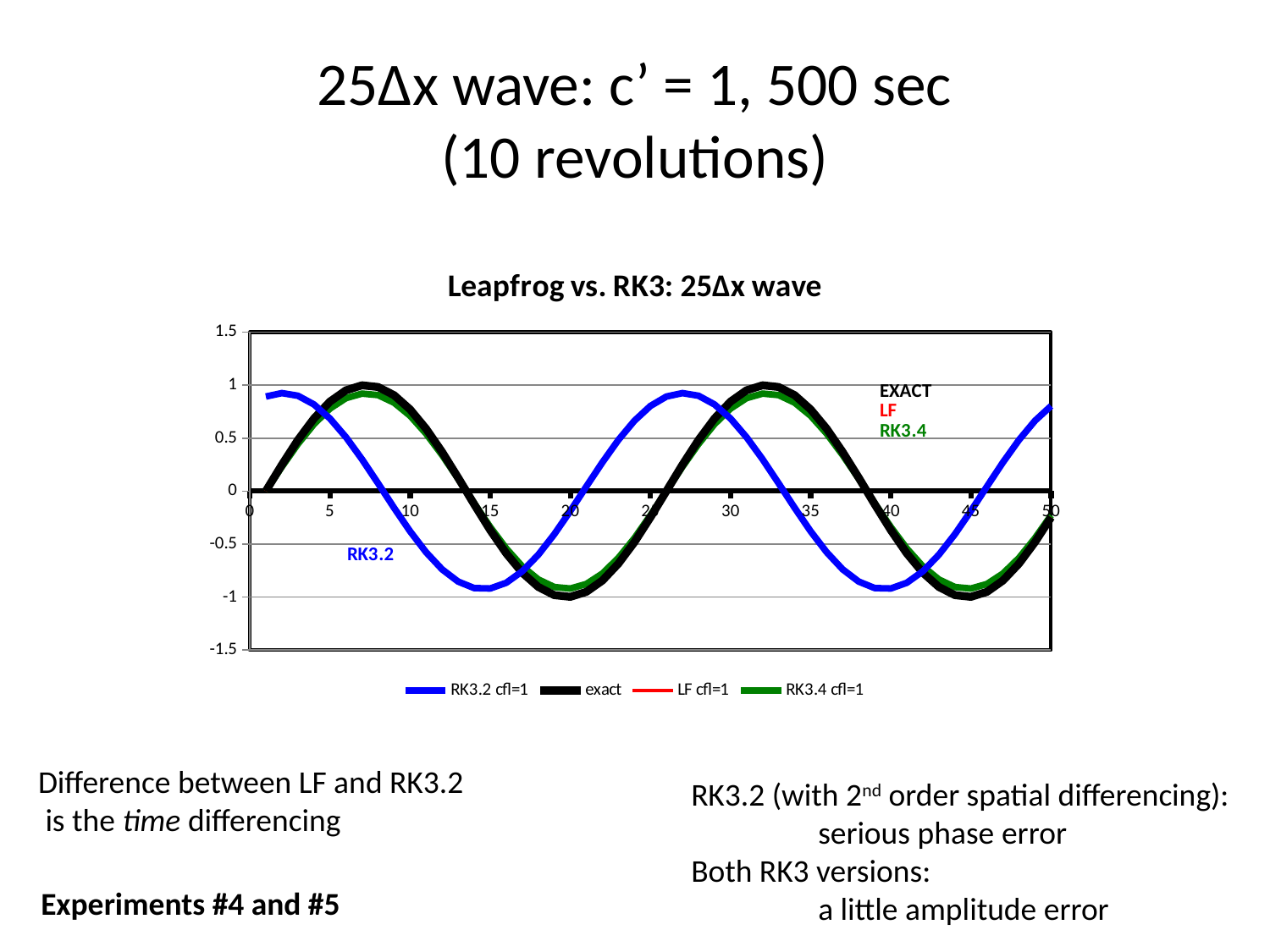
Is the value of the exact series at x = 7 greater or less than 0.5? greater What kind of chart is shown on the slide? line chart How many series does the chart legend list? 4 Which series is drawn in blue? RK3.2 cfl=1 Does the exact series rise or fall between x = 7 and x = 20? fall At x = 10, which series has the larger value: exact or RK3.2 cfl=1? exact Is the value of the exact series at x = 20 greater or less than -0.5? less Is the value of the RK3.2 cfl=1 series at x = 15 greater or less than -0.5? less At x = 27, which series has the larger value: RK3.2 cfl=1 or exact? RK3.2 cfl=1 What is the title of the chart? Leapfrog vs. RK3: 25Δx wave